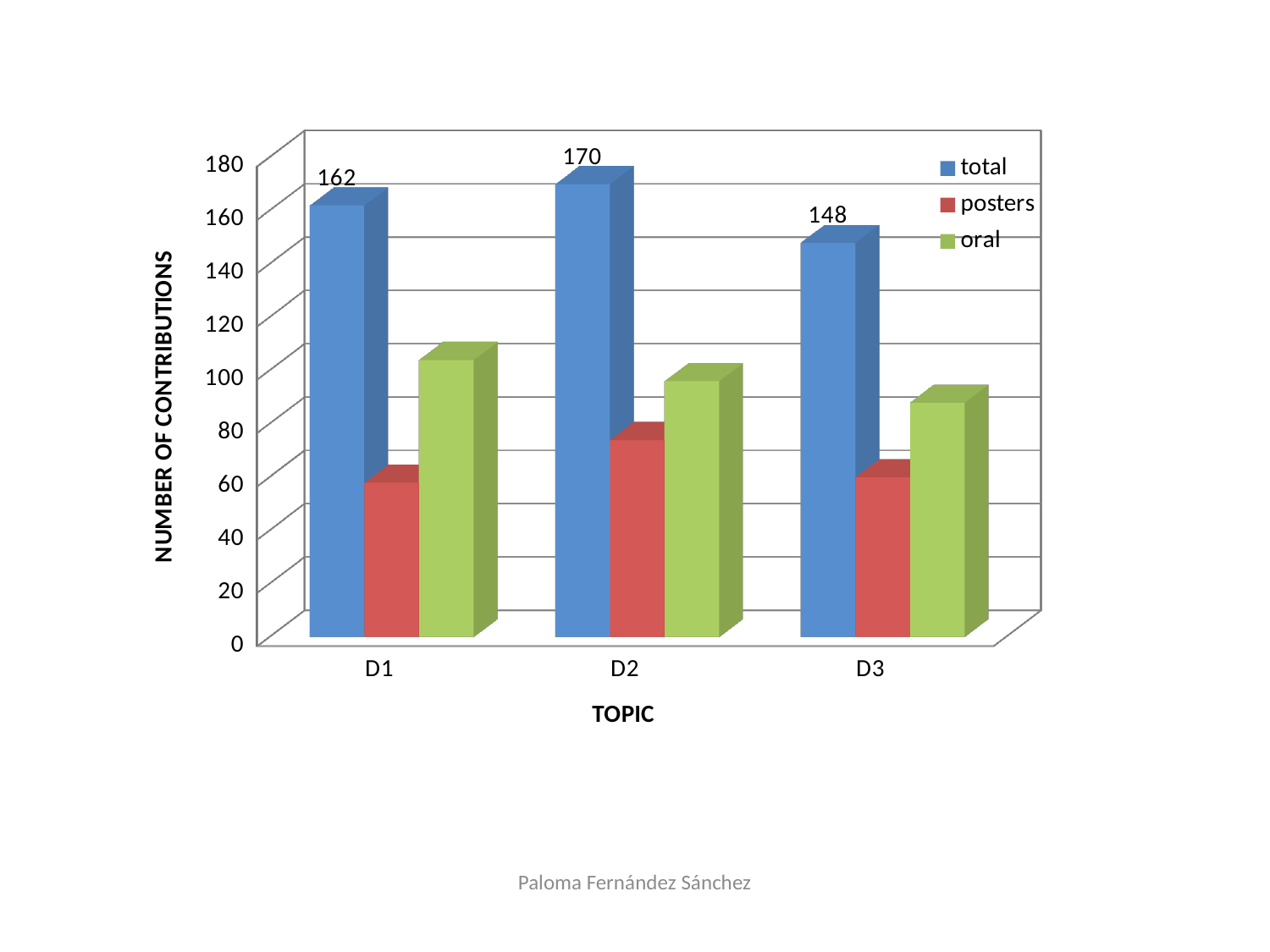
What is the total number of contributions for topic D2? 170 Which topic has the lowest total number of contributions? D3 For topic D1, which is larger: the number of posters or the number of oral contributions? oral What is the difference between the total contributions for D2 and D3? 22 What is the difference between the total contributions for D2 and D1? 8 Is the number of oral contributions for D1 greater or less than 80? greater What kind of chart is shown on the slide? bar chart Is the number of posters for D1 greater or less than 40? greater Which topic has the highest total number of contributions? D2 What is the total number of contributions for topic D1? 162 How many series does the legend list? 3 What is the total number of contributions for topic D3? 148